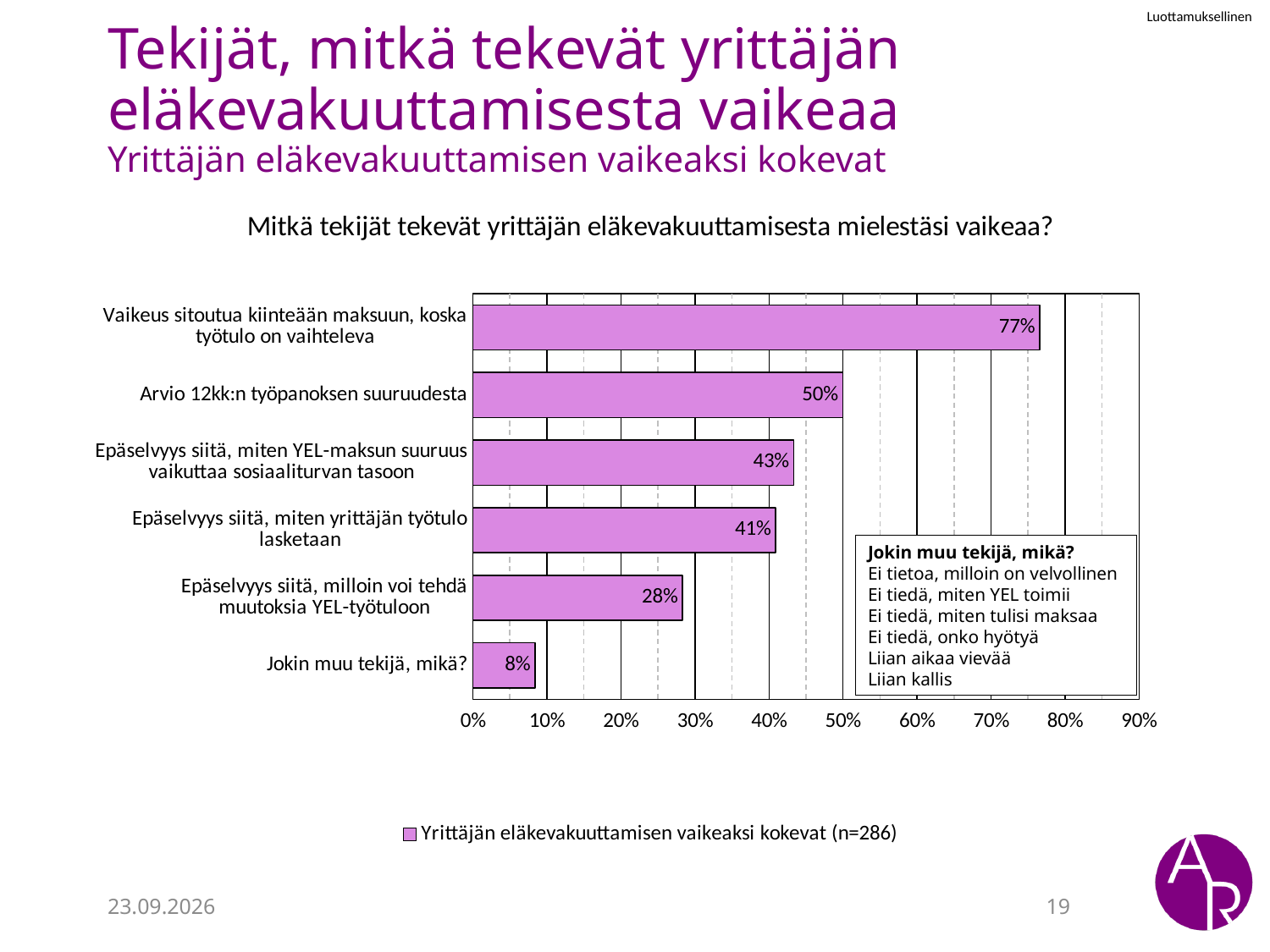
How many categories are shown in the chart? 6 What is the difference between the values for "Vaikeus sitoutua kiinteään maksuun, koska työtulo on vaihteleva" and "Arvio 12kk:n työpanoksen suuruudesta"? 27% Is the value for "Epäselvyys siitä, miten yrittäjän työtulo lasketaan" greater or less than 50%? less How many series does the legend list? 1 Which category has the lowest value? Jokin muu tekijä, mikä? Which category has the highest value? Vaikeus sitoutua kiinteään maksuun, koska työtulo on vaihteleva What is the value for "Epäselvyys siitä, milloin voi tehdä muutoksia YEL-työtuloon"? 28% What is the sample size (n) given in the legend entry? n=286 What kind of chart is shown on the slide? bar chart Which is larger: the value for "Epäselvyys siitä, miten YEL-maksun suuruus vaikuttaa sosiaaliturvan tasoon" or the value for "Epäselvyys siitä, milloin voi tehdä muutoksia YEL-työtuloon"? Epäselvyys siitä, miten YEL-maksun suuruus vaikuttaa sosiaaliturvan tasoon What is the value for "Jokin muu tekijä, mikä?"? 8% What is the value for "Arvio 12kk:n työpanoksen suuruudesta"? 50%